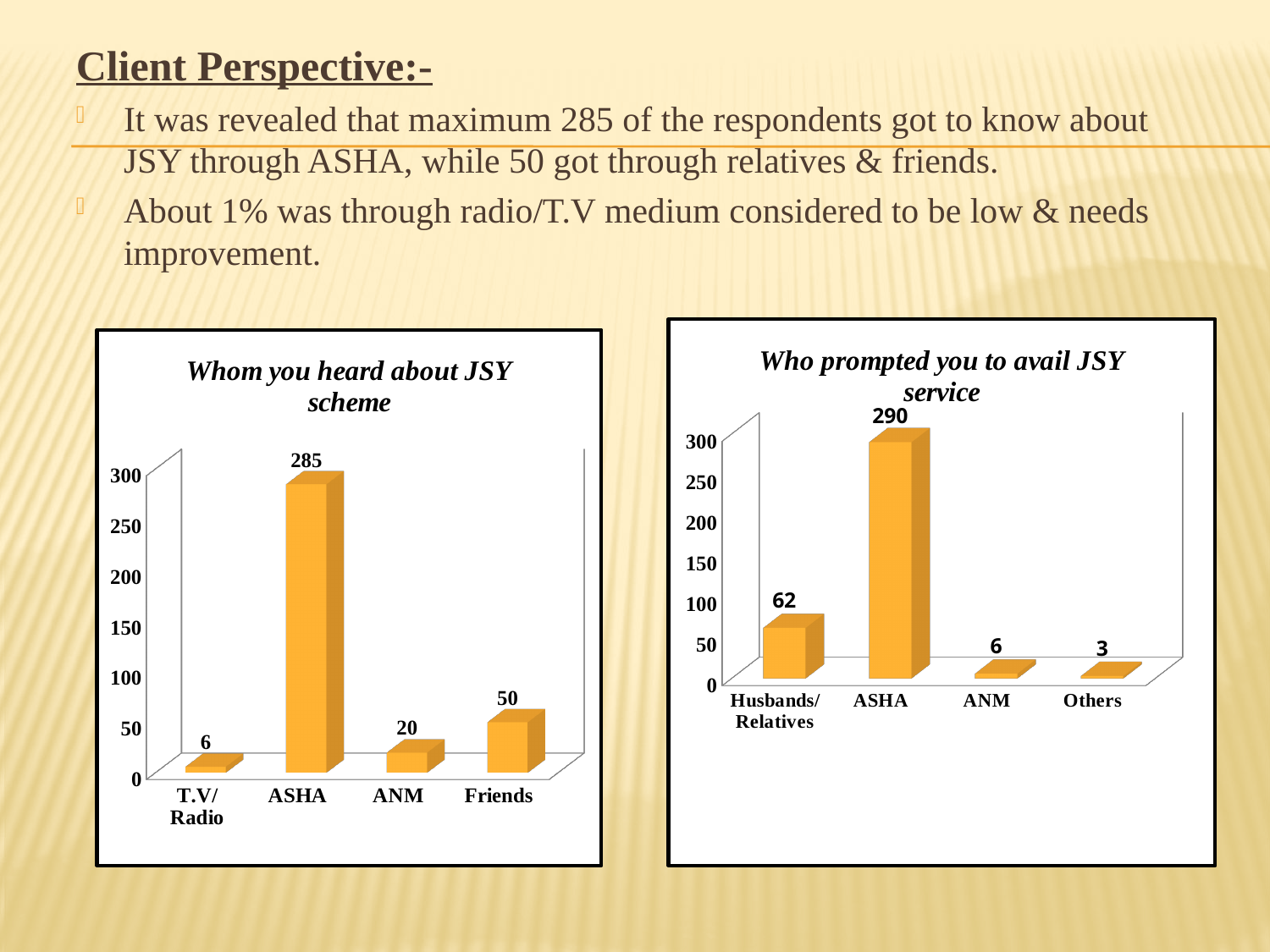
In the chart titled 'Who prompted you to avail JSY service', what is the difference between the values for ASHA and Husbands/ Relatives? 228 In the chart titled 'Whom you heard about JSY scheme', how many categories are shown? 4 In the chart titled 'Whom you heard about JSY scheme', what is the value for Friends? 50 What kind of chart is the chart titled 'Whom you heard about JSY scheme'? Bar chart In the chart titled 'Who prompted you to avail JSY service', what is the value for Others? 3 In the chart titled 'Whom you heard about JSY scheme', what is the difference between the values for Friends and ANM? 30 In the chart titled 'Who prompted you to avail JSY service', is the value for Husbands/ Relatives greater or less than 100? less In the chart titled 'Whom you heard about JSY scheme', which category has the lowest value? T.V/ Radio In the chart titled 'Whom you heard about JSY scheme', what is the value for ASHA? 285 In the chart titled 'Who prompted you to avail JSY service', which category has the highest value? ASHA In the chart titled 'Who prompted you to avail JSY service', which is larger, the value for ANM or the value for Others? ANM In the chart titled 'Who prompted you to avail JSY service', what is the value for Husbands/ Relatives? 62